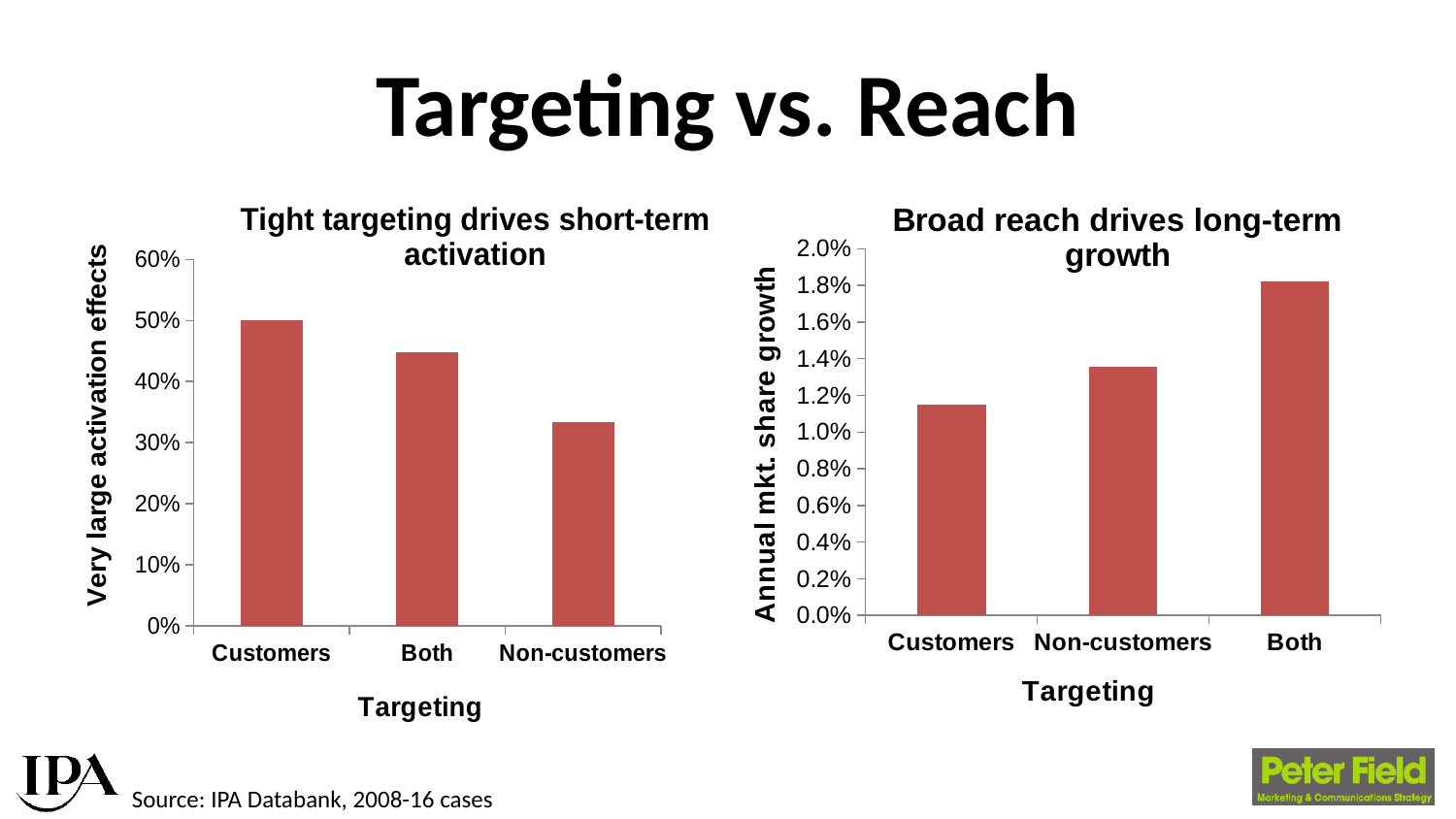
In the chart titled 'Broad reach drives long-term growth', is the value for Both greater or less than 1.6%? greater In the chart titled 'Broad reach drives long-term growth', is the value for Customers greater or less than 1.2%? less In the chart titled 'Broad reach drives long-term growth', which targeting category has the lowest annual market share growth? Customers In the chart titled 'Tight targeting drives short-term activation', is the value for Both greater or less than 40%? greater In the chart titled 'Tight targeting drives short-term activation', which targeting category has the highest value? Customers In the chart titled 'Tight targeting drives short-term activation', which targeting category has the lowest value? Non-customers In the chart titled 'Tight targeting drives short-term activation', how many targeting categories are shown? 3 What is the y-axis label of the chart titled 'Tight targeting drives short-term activation'? Very large activation effects What kind of chart is the chart titled 'Broad reach drives long-term growth'? bar chart In the chart titled 'Broad reach drives long-term growth', which is larger, the value for Non-customers or the value for Customers? Non-customers In the chart titled 'Broad reach drives long-term growth', which targeting category has the highest annual market share growth? Both